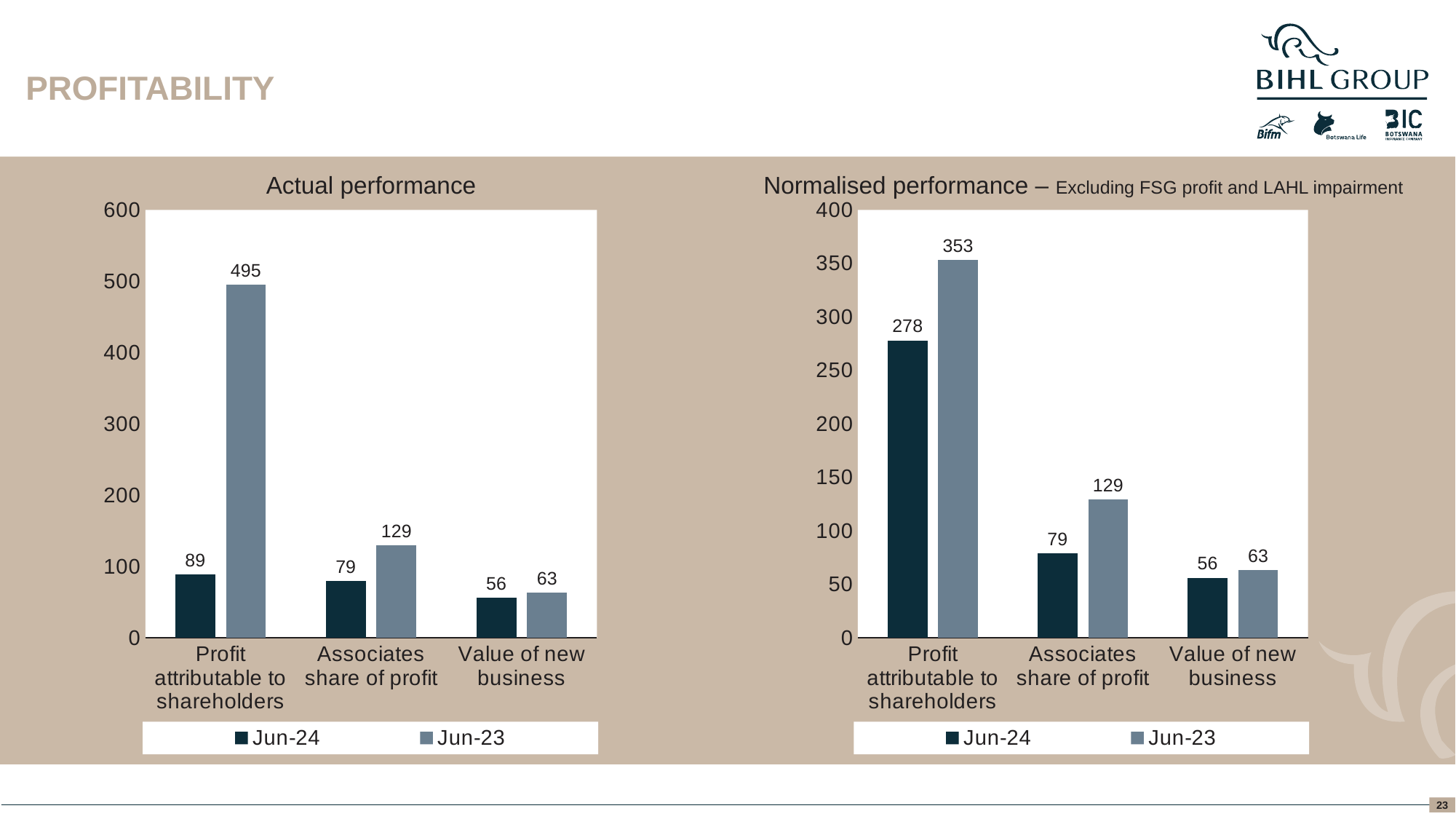
In the 'Normalised performance' chart, what is the difference between the Jun-23 and Jun-24 values for Profit attributable to shareholders? 75 In the 'Actual performance' chart, what is the Jun-24 value for Value of new business? 56 In the 'Normalised performance' chart, what is the Jun-23 value for Associates share of profit? 129 In the 'Actual performance' chart, which category has the highest Jun-23 value? Profit attributable to shareholders How many categories are shown on the x axis of the 'Normalised performance' chart? 3 In the 'Normalised performance' chart, what is the Jun-24 value for Profit attributable to shareholders? 278 In the 'Actual performance' chart, what is the Jun-23 value for Profit attributable to shareholders? 495 In the 'Actual performance' chart, is the Jun-24 value for Associates share of profit larger or smaller than the Jun-23 value? smaller In the 'Actual performance' chart, what is the difference between the Jun-23 and Jun-24 values for Profit attributable to shareholders? 406 How many series does the legend of the 'Actual performance' chart list? 2 What type of chart is the 'Normalised performance' chart? Bar chart In the 'Normalised performance' chart, which category has the lowest Jun-24 value? Value of new business